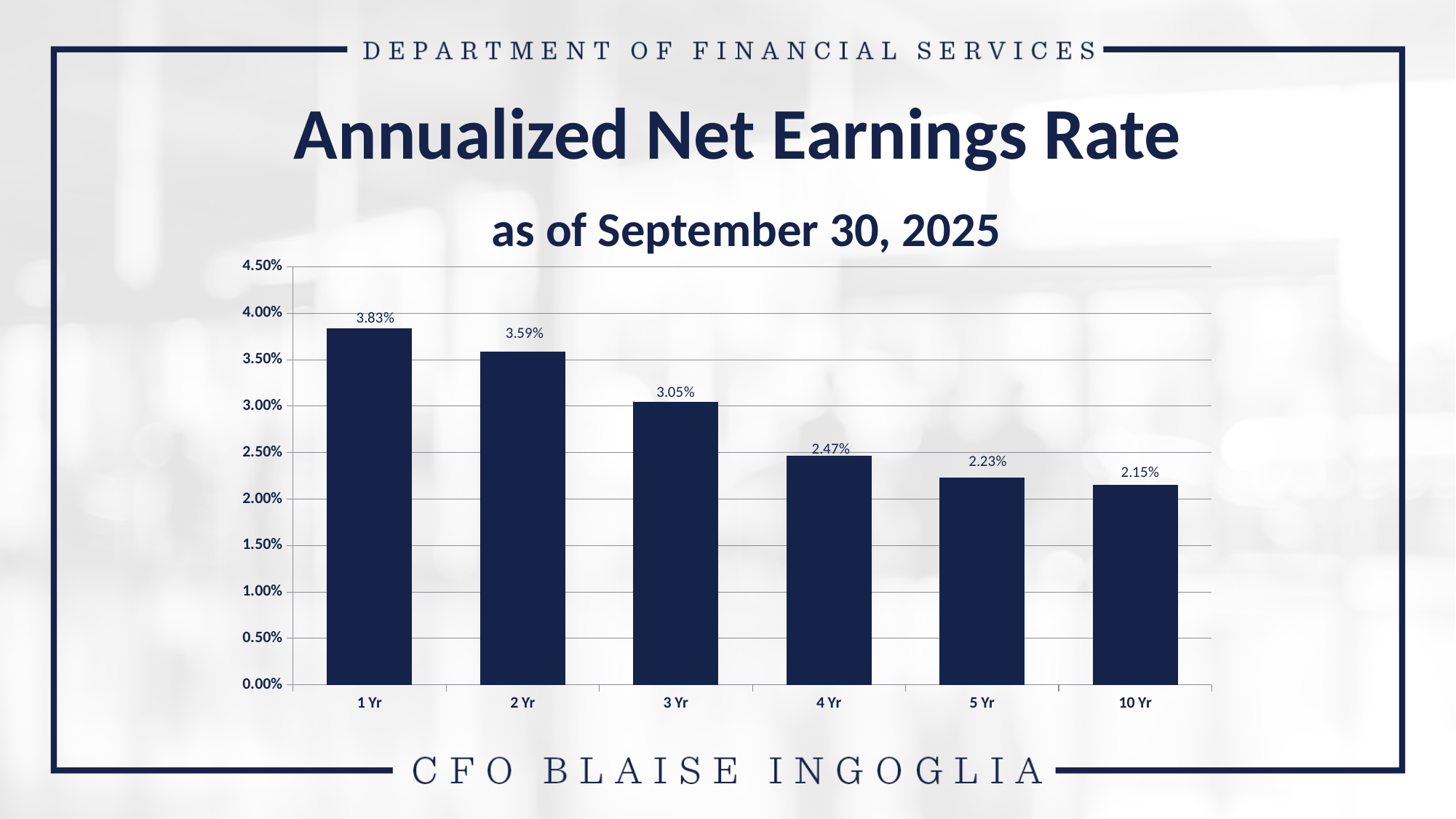
Which is larger, the 2 Yr rate or the 3 Yr rate? 2 Yr What is the annualized net earnings rate for 1 Yr? 3.83% What kind of chart is shown on the slide? Bar chart Is the value for 4 Yr greater or less than 2.50%? less What is the annualized net earnings rate for 10 Yr? 2.15% What is the annualized net earnings rate for 3 Yr? 3.05% What is the difference between the 4 Yr and 5 Yr annualized net earnings rates? 0.24% Which period has the lowest annualized net earnings rate? 10 Yr How many periods are shown on the x axis? 6 Which period has the highest annualized net earnings rate? 1 Yr Do the values rise or fall as the period lengthens from 1 Yr to 10 Yr? Fall What is the difference between the 1 Yr and 2 Yr annualized net earnings rates? 0.24%